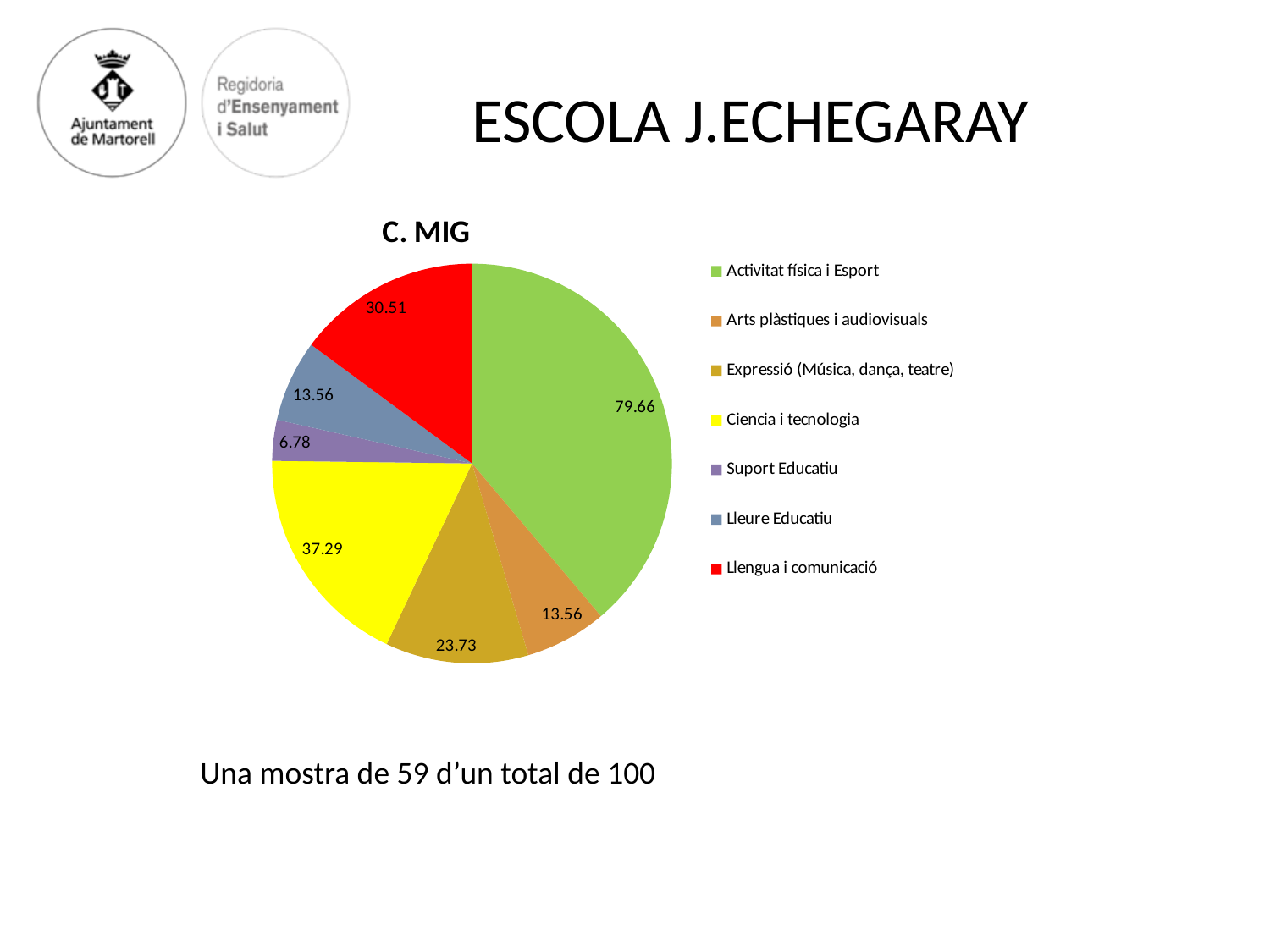
What is the value shown for Expressió (Música, dança, teatre)? 23.73 Which category has the largest slice of the pie? Activitat física i Esport What is the value shown for Ciencia i tecnologia? 37.29 What is the value shown for Llengua i comunicació? 30.51 What is the title of the chart? C. MIG How many categories does the legend of the chart list? 7 Which category has the smallest slice of the pie? Suport Educatiu What is the difference between the values for Activitat física i Esport and Ciencia i tecnologia? 42.37 Which is larger, the value for Llengua i comunicació or the value for Expressió (Música, dança, teatre)? Llengua i comunicació What is the value shown for Activitat física i Esport? 79.66 What kind of chart is shown on the slide? pie chart What is the value shown for Suport Educatiu? 6.78